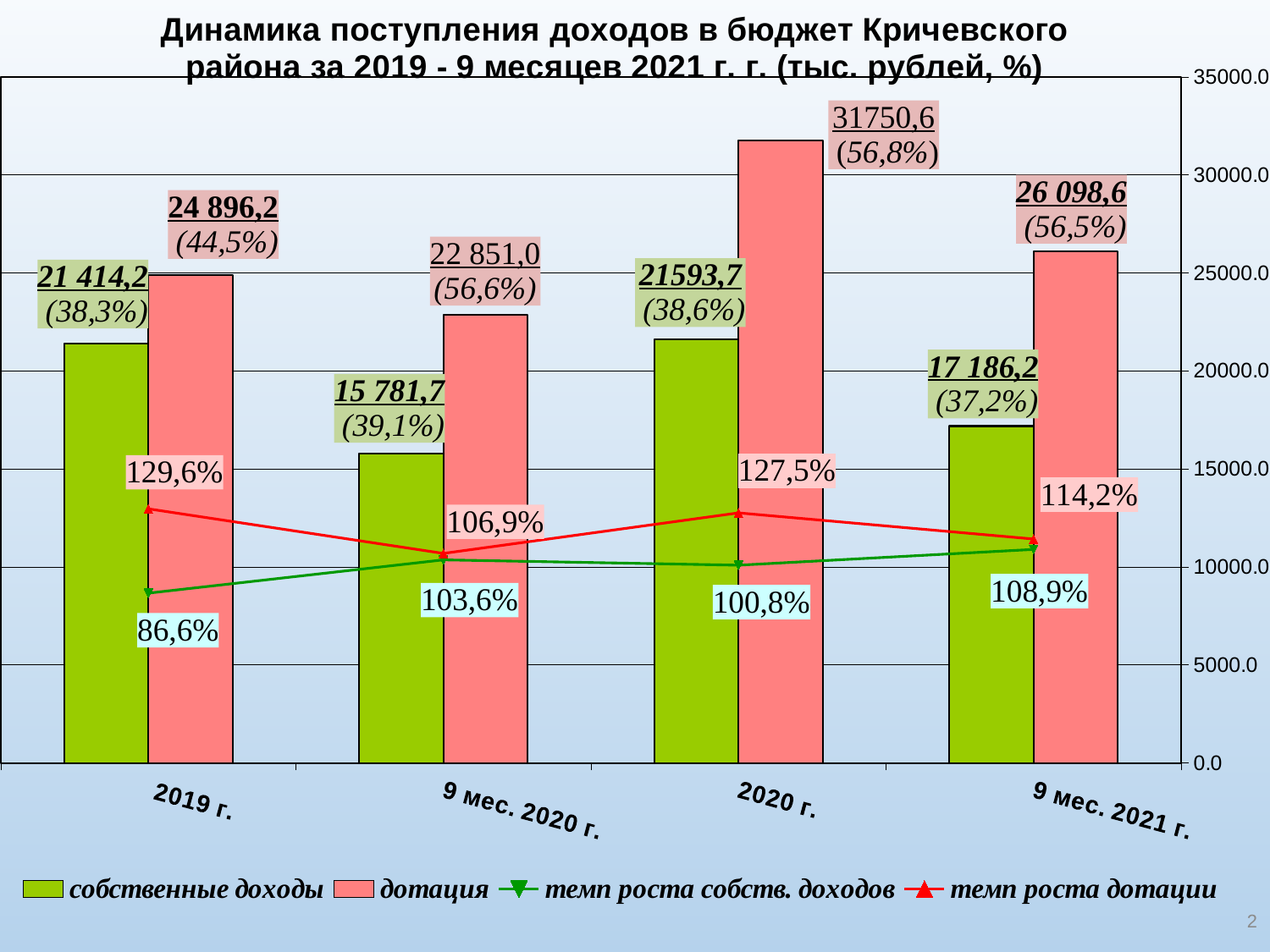
How many series does the legend list? 4 What is the value of собственные доходы for 2019 г.? 21 414,2 Which category has the highest дотация value? 2020 г. What is the value of дотация for 2020 г.? 31750,6 What percentage share is shown in parentheses for дотация in 9 мес. 2020 г.? 56,6% What is the темп роста собств. доходов value for 2019 г.? 86,6% Which category has the lowest собственные доходы value? 9 мес. 2020 г. What is the темп роста дотации value for 9 мес. 2021 г.? 114,2% How many categories are shown on the x axis? 4 Which is larger for 9 мес. 2021 г.: собственные доходы or дотация? дотация What kind of chart is this? Combined bar and line chart Which category has the lowest темп роста собств. доходов value? 2019 г.